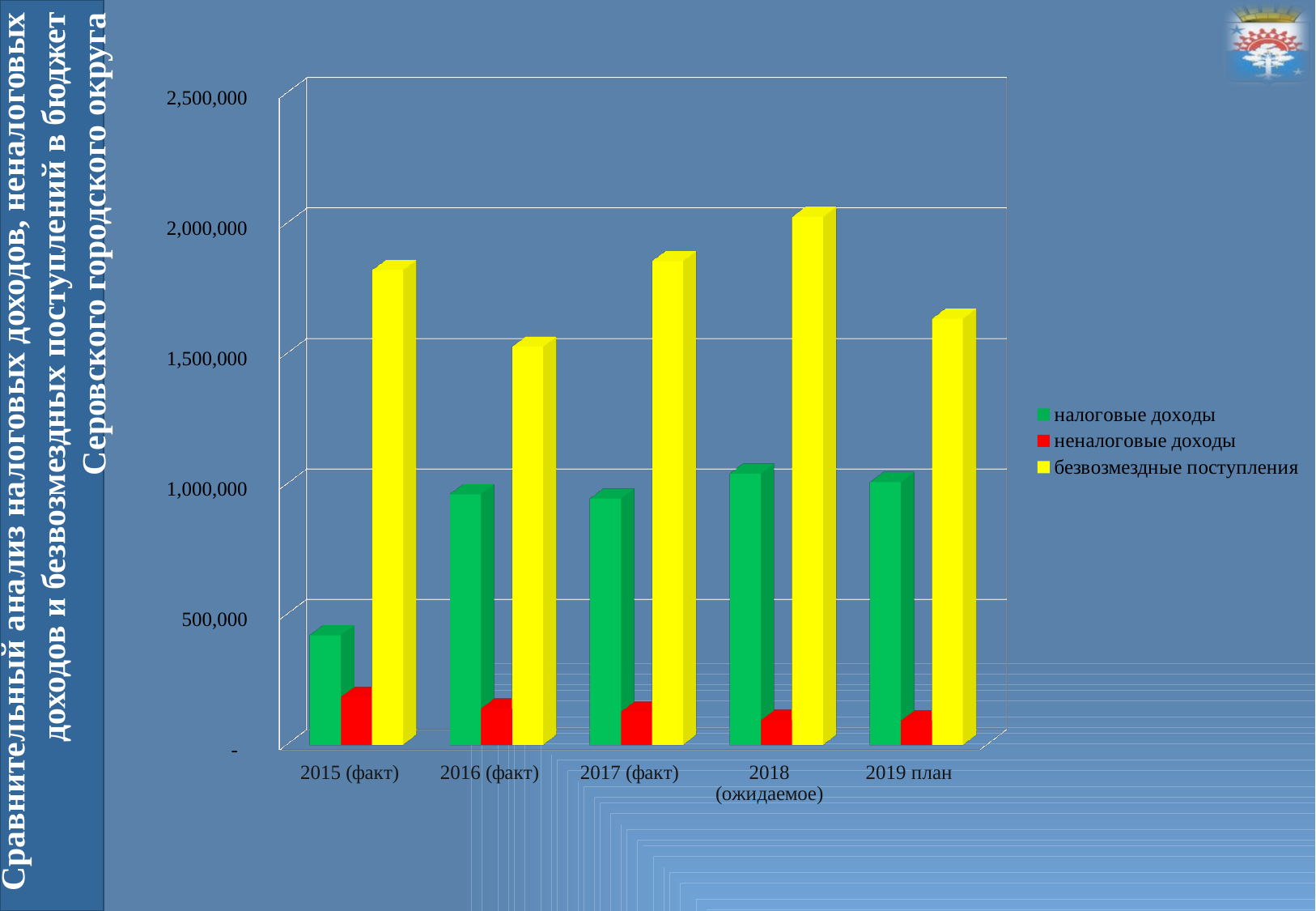
Which is larger: налоговые доходы in 2015 (факт) or in 2016 (факт)? 2016 (факт) What kind of chart is shown on the slide? bar chart In which year is the value for неналоговые доходы the highest? 2015 (факт) Which colour represents безвозмездные поступления in the legend? yellow In which year is the value for безвозмездные поступления the highest? 2018 (ожидаемое) Is the value for безвозмездные поступления in 2015 (факт) greater or less than 2,000,000? less How many series does the legend list? 3 In which year is the value for налоговые доходы the lowest? 2015 (факт) Is the value for налоговые доходы in 2015 (факт) greater or less than 500,000? less How many year categories are shown on the x axis? 5 In which year is the value for безвозмездные поступления the lowest? 2016 (факт)